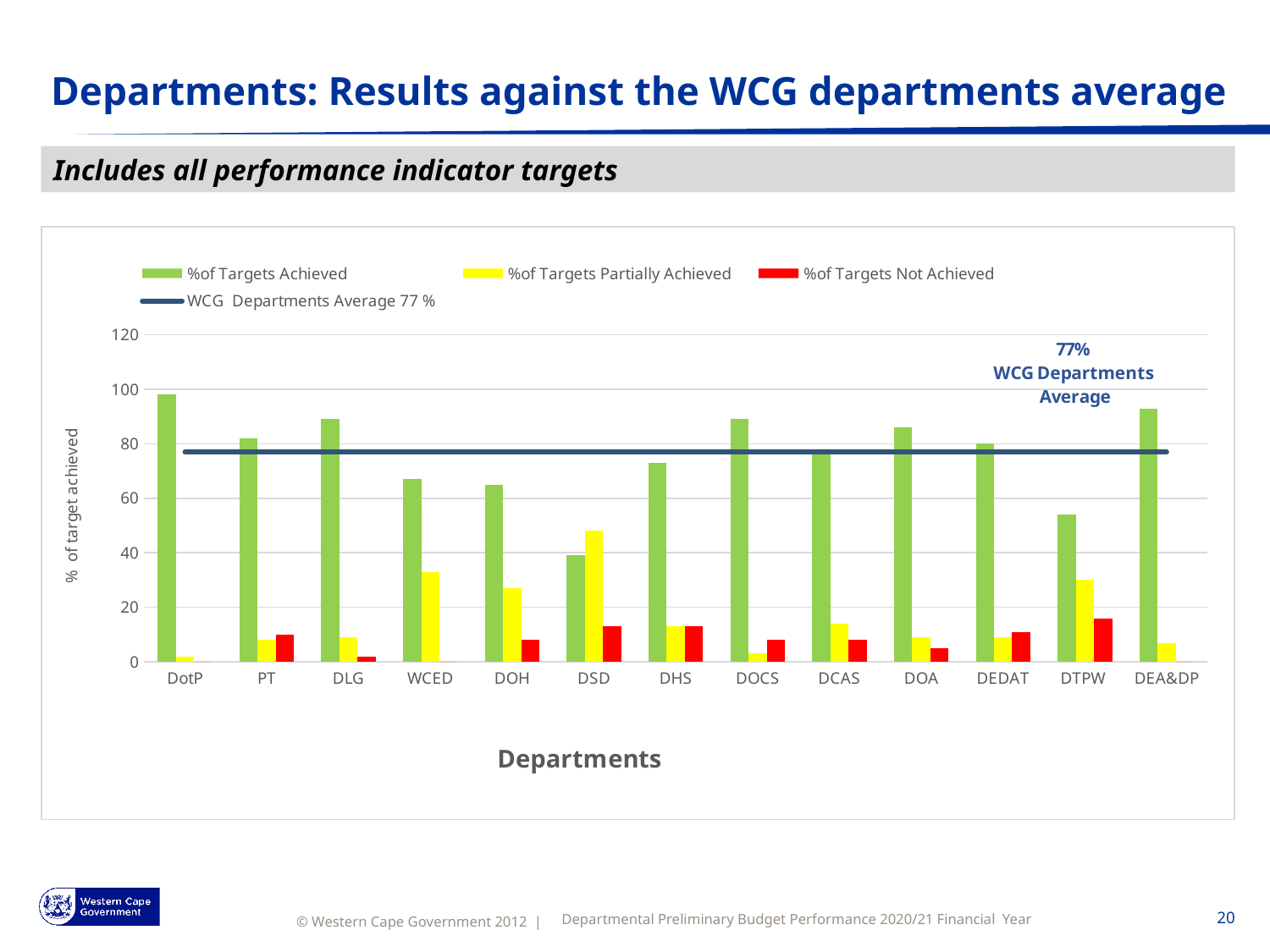
How many departments are shown along the x axis of the chart? 13 Which is larger, the % of Targets Achieved for DLG or for WCED? DLG What is the label on the x axis of the chart? Departments How many entries does the chart legend list? 4 Which department has the highest % of Targets Achieved? DotP What kind of chart is shown on the slide? bar chart Is the % of Targets Achieved for DTPW greater or less than 60? less Which department has the lowest % of Targets Achieved? DSD Is the % of Targets Partially Achieved for WCED greater or less than 20? greater What is the WCG Departments Average value marked by the horizontal line on the chart? 77% Is the % of Targets Achieved for DotP greater or less than 80? greater Which department has the highest % of Targets Partially Achieved? DSD